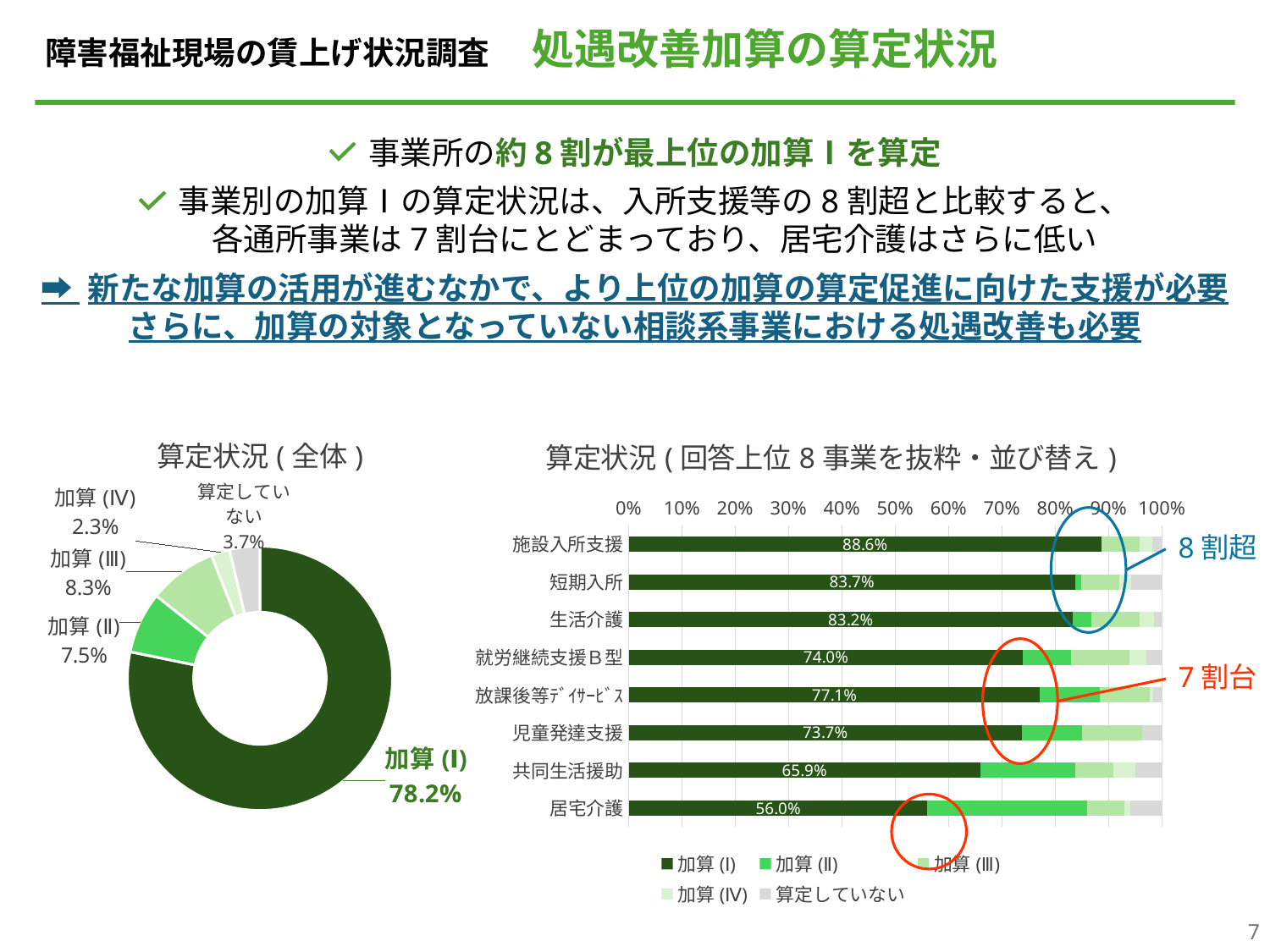
In the chart titled 算定状況(回答上位8事業を抜粋・並び替え), which has a higher 加算(I) value, 就労継続支援B型 or 放課後等デイサービス? 放課後等デイサービス In the chart titled 算定状況(回答上位8事業を抜粋・並び替え), how many categories (事業) are shown? 8 In the chart titled 算定状況(全体), which category has the smallest share? 加算(IV) In the chart titled 算定状況(全体), what kind of chart is shown? Donut (pie) chart In the chart titled 算定状況(回答上位8事業を抜粋・並び替え), which category has the lowest 加算(I) value? 居宅介護 In the chart titled 算定状況(回答上位8事業を抜粋・並び替え), what is the 加算(I) value for 居宅介護? 56.0% In the chart titled 算定状況(回答上位8事業を抜粋・並び替え), what is the 加算(I) value for 施設入所支援? 88.6% In the chart titled 算定状況(回答上位8事業を抜粋・並び替え), how many series does the legend list? 5 In the chart titled 算定状況(全体), what is the difference between 加算(III) and 加算(II)? 0.8% In the chart titled 算定状況(回答上位8事業を抜粋・並び替え), what is the difference in 加算(I) between 施設入所支援 and 共同生活援助? 22.7% In the chart titled 算定状況(全体), what is the value for 算定していない? 3.7% In the chart titled 算定状況(全体), what is the value for 加算(I)? 78.2%